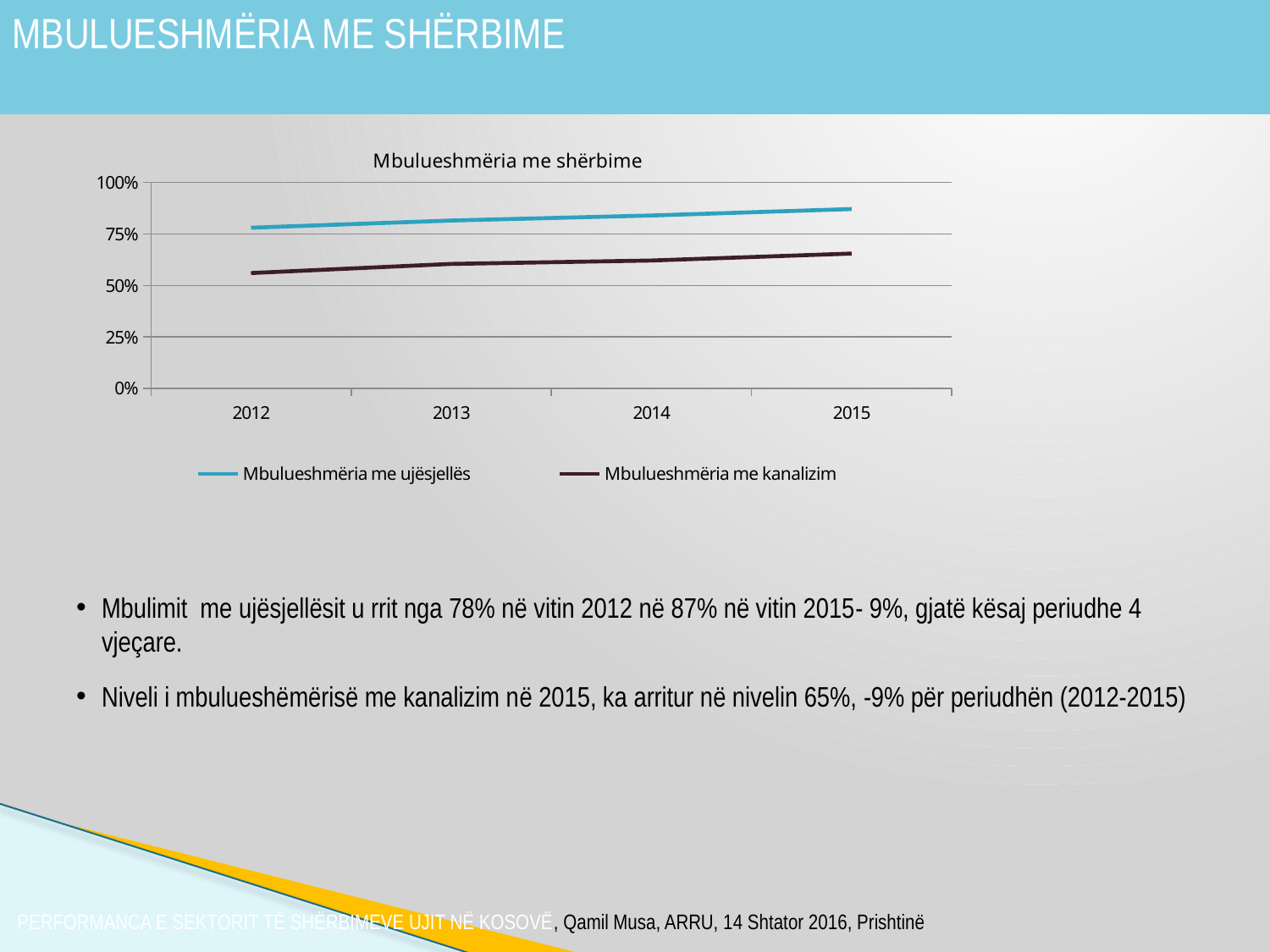
According to the slide, what was the value for Mbulueshmëria me kanalizim in 2015? 65% Is the value for Mbulueshmëria me kanalizim in 2015 greater or less than 50%? greater According to the slide, what was the value for Mbulueshmëria me ujësjellës in 2015? 87% Which series is plotted higher across all years, Mbulueshmëria me ujësjellës or Mbulueshmëria me kanalizim? Mbulueshmëria me ujësjellës What is the title of the chart? Mbulueshmëria me shërbime Does the Mbulueshmëria me kanalizim line rise or fall from 2012 to 2015? rise Is the value for Mbulueshmëria me kanalizim in 2012 greater or less than 75%? less Does the Mbulueshmëria me ujësjellës line rise or fall from 2012 to 2015? rise Is the value for Mbulueshmëria me ujësjellës in 2012 greater or less than 75%? greater How many series does the chart legend list? 2 What kind of chart is shown on the slide? line chart How many years are shown on the x axis of the chart? 4